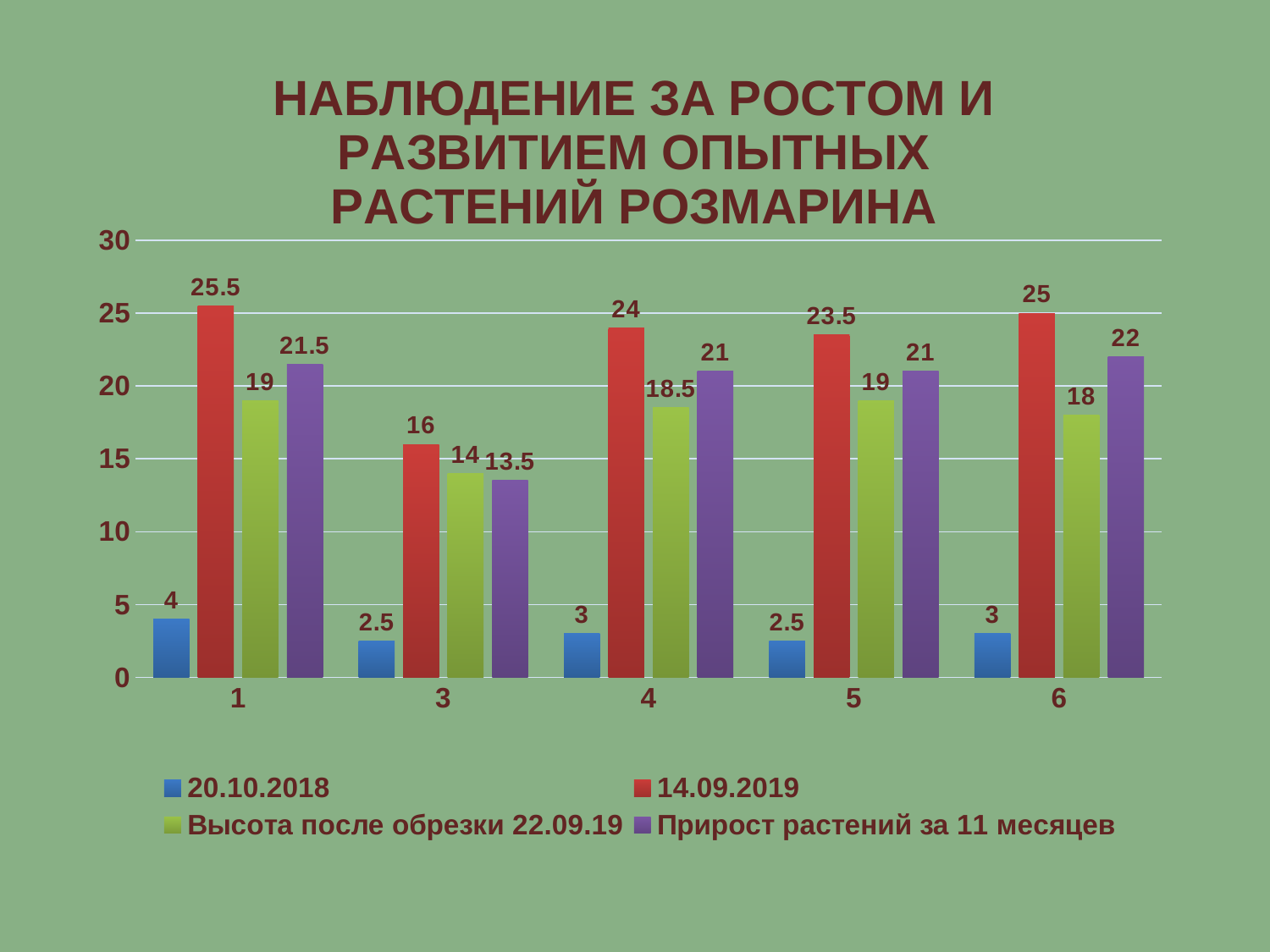
What is the difference between the 14.09.2019 value and the 20.10.2018 value for category 6? 22 What colour are the bars for the 20.10.2018 series? blue What is the value for category 3 in the Прирост растений за 11 месяцев series? 13.5 Which category has the lowest value in the Прирост растений за 11 месяцев series? 3 What type of chart is shown on the slide? bar chart How many categories are shown on the x axis? 5 What is the value for category 1 in the 14.09.2019 series? 25.5 Is the 14.09.2019 value for category 3 greater or less than 20? less Which category has the highest value in the 14.09.2019 series? 1 How many series does the legend list? 4 Which is larger for category 5: the Высота после обрезки 22.09.19 value or the Прирост растений за 11 месяцев value? Прирост растений за 11 месяцев What is the value for category 4 in the Высота после обрезки 22.09.19 series? 18.5